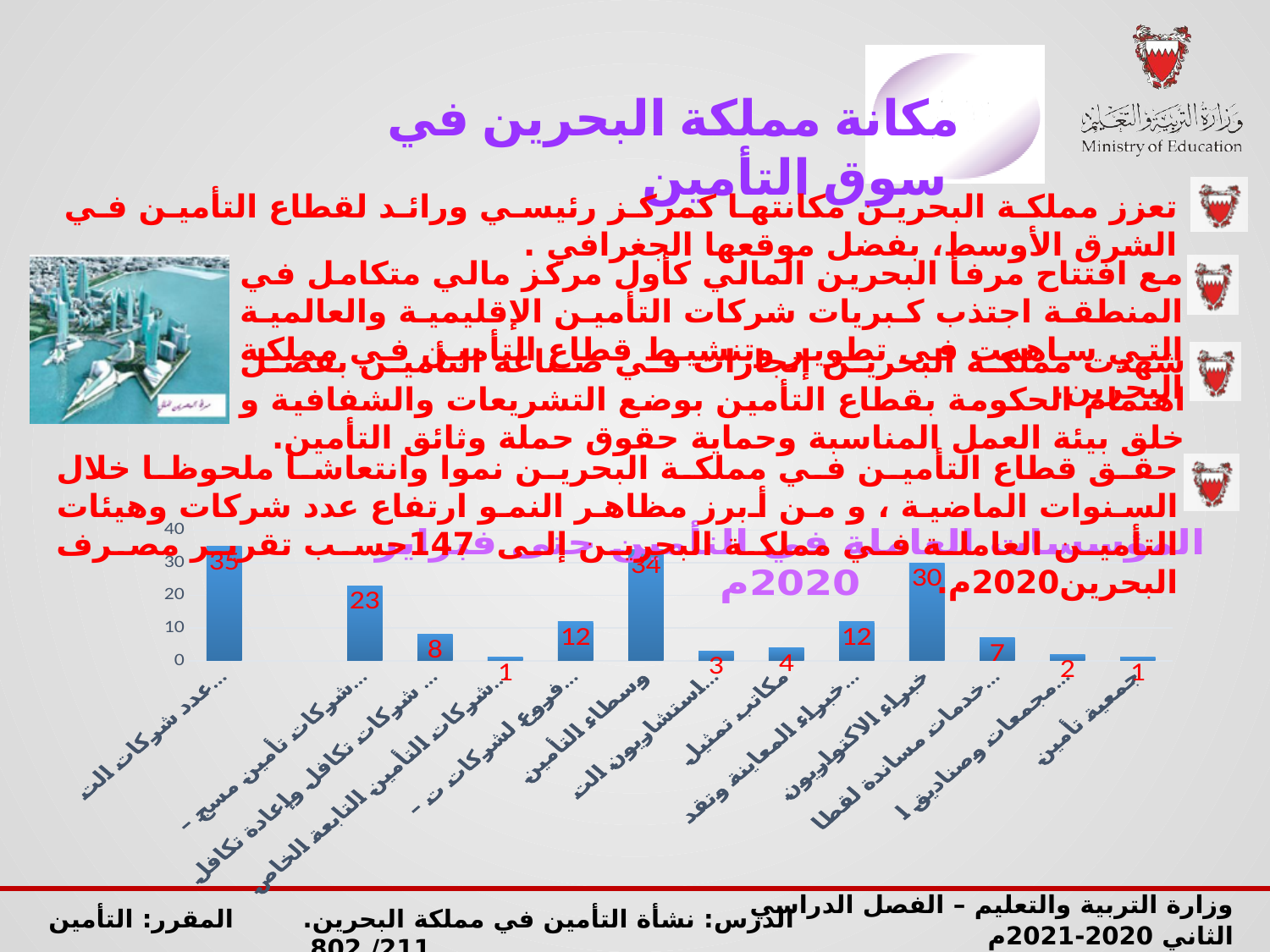
What is the value for مجمعات وصناديق ا... (pools and funds)? 2 What is the value for وسطاء التأمين (insurance brokers)? 34 What is the value for خبراء الاكتواريون (actuaries)? 30 Which is larger: the value for مكاتب تمثيل or the value for خدمات مساندة لقطا...? خدمات مساندة لقطا... (7) What is the difference between the highest bar (35) and the bar for شركات تأمين مسج... (23)? 12 What type of chart is shown on the slide? bar chart Which category has the highest value in the chart? عدد شركات الت... (35) What is the value for جمعية تأمين (insurance association)? 1 How many categories (bars) does the chart show? 13 What is the value for مكاتب تمثيل (representative offices)? 4 What is the difference between the value for وسطاء التأمين (34) and the value for خبراء الاكتواريون (30)? 4 What is the value for شركات تكافل وإعادة تكافل (takaful and retakaful companies)? 8